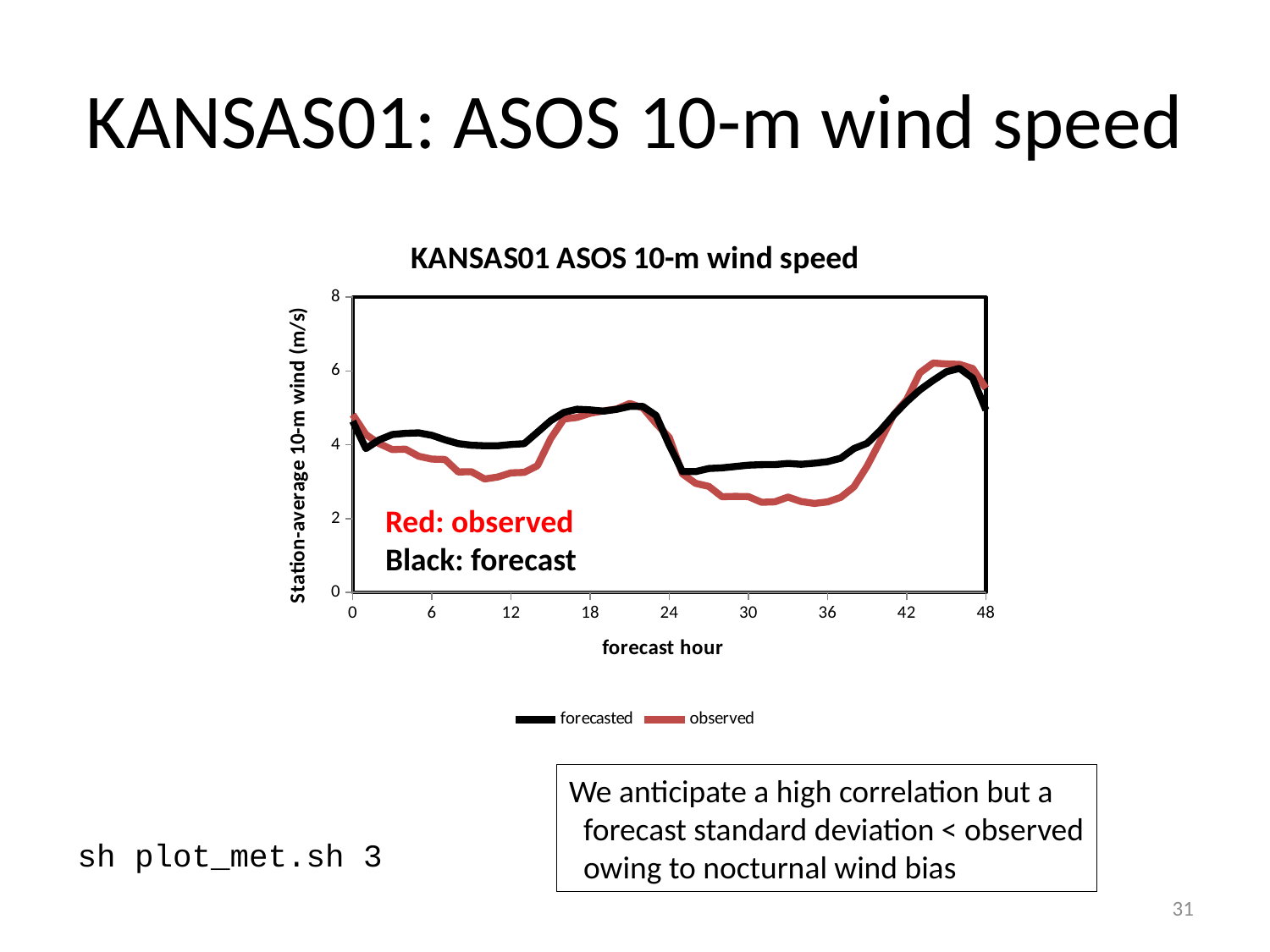
Is the forecasted value at forecast hour 30 greater or less than 4? less Is the observed value at forecast hour 10 greater or less than 4? less Which colour is used for the observed series? red At forecast hour 10, which series has the higher value, forecasted or observed? forecasted Is the forecasted value at forecast hour 20 greater or less than 4? greater How many series does the chart legend list? 2 At forecast hour 36, which series has the higher value, forecasted or observed? forecasted Does the observed line rise or fall between forecast hour 36 and forecast hour 44? rise What kind of chart is shown on the slide? line chart What is the title of the chart? KANSAS01 ASOS 10-m wind speed